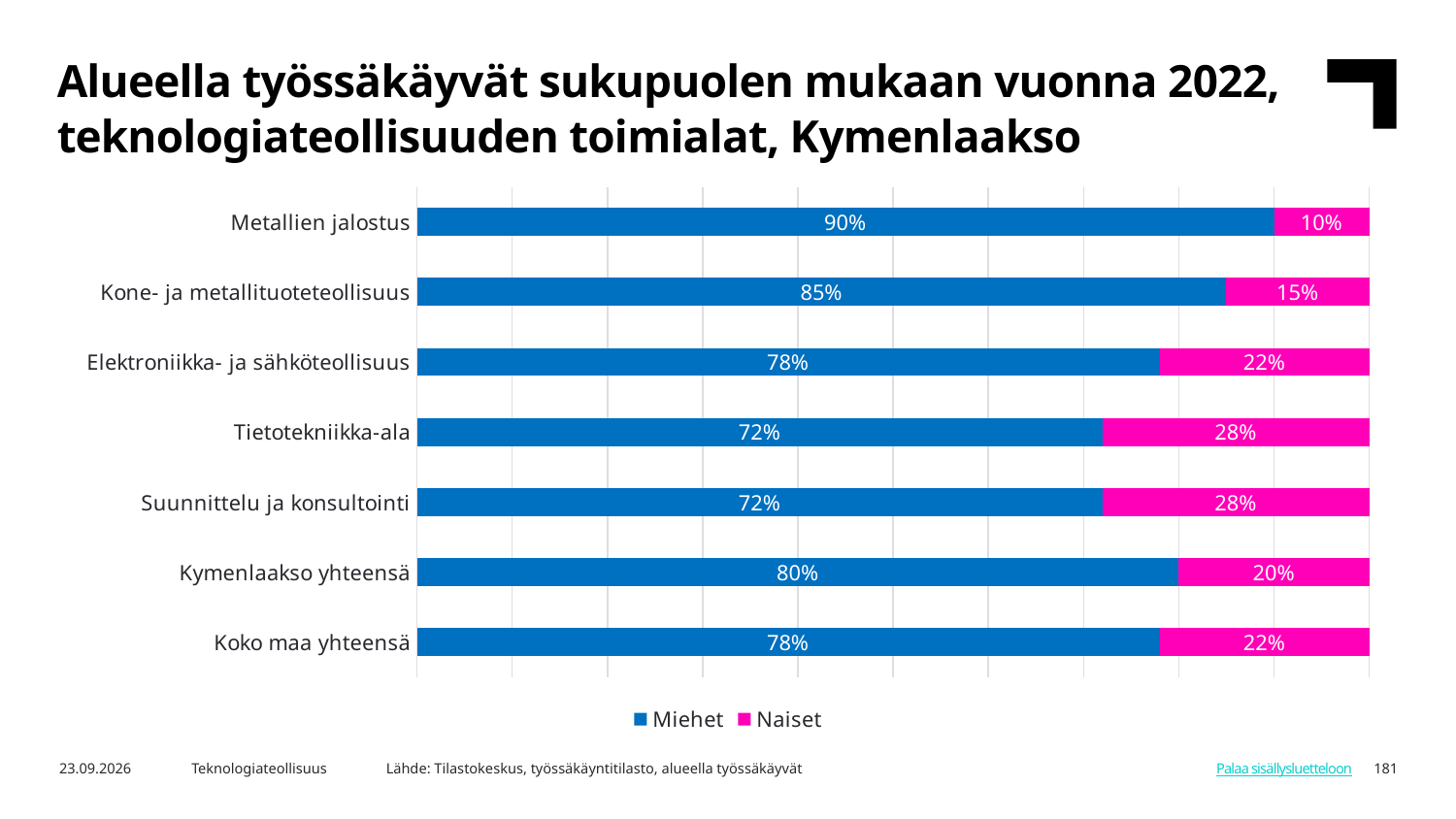
What is the total of the stacked bar for Suunnittelu ja konsultointi? 100% Which is larger, the Naiset value for Elektroniikka- ja sähköteollisuus or for Kone- ja metallituoteteollisuus? Elektroniikka- ja sähköteollisuus How many series does the legend list? 2 What is the Naiset value for Kymenlaakso yhteensä? 20% Which category has the lowest Naiset share? Metallien jalostus What kind of chart is shown on the slide? Stacked bar chart What is the Naiset value for Kone- ja metallituoteteollisuus? 15% What is the Miehet value for Metallien jalostus? 90% What is the Miehet value for Koko maa yhteensä? 78% How many categories are shown on the chart? 7 What is the difference between the Miehet values for Metallien jalostus and Tietotekniikka-ala? 18 percentage points Which category has the highest Naiset share? Tietotekniikka-ala and Suunnittelu ja konsultointi